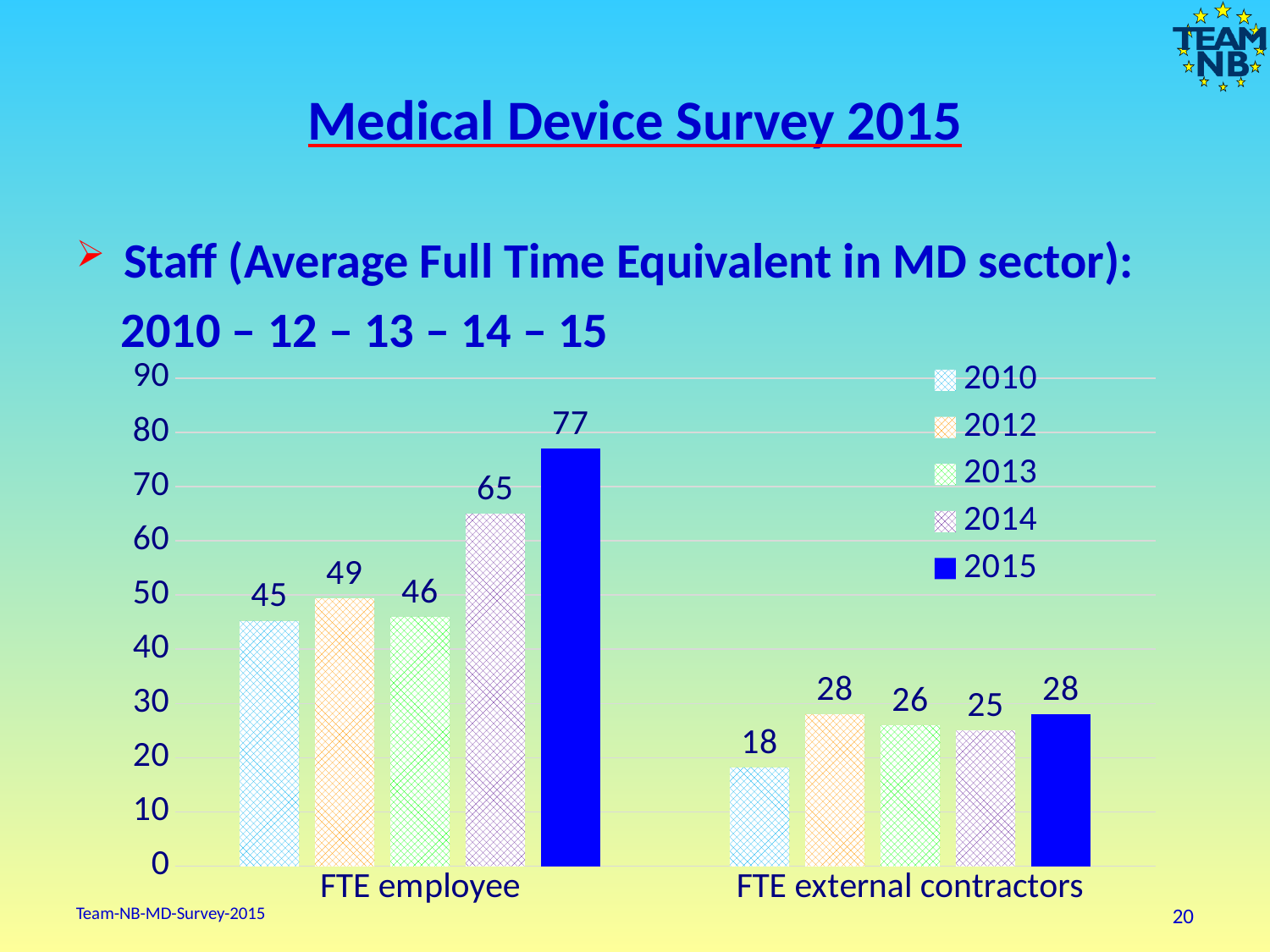
Which year has the highest value for FTE employee? 2015 Which series is shown as a solid blue bar in the legend? 2015 Which year has the lowest value for FTE external contractors? 2010 Which is larger: FTE employee in 2012 or FTE employee in 2013? 2012 What kind of chart is shown on the slide? Bar chart What is the value for FTE employee in 2015? 77 What is the difference between the FTE external contractors values for 2012 and 2010? 10 How many categories are shown on the x axis? 2 What is the difference between the FTE employee values for 2015 and 2014? 12 What is the value for FTE external contractors in 2010? 18 What is the value for FTE employee in 2013? 46 How many series does the legend list? 5